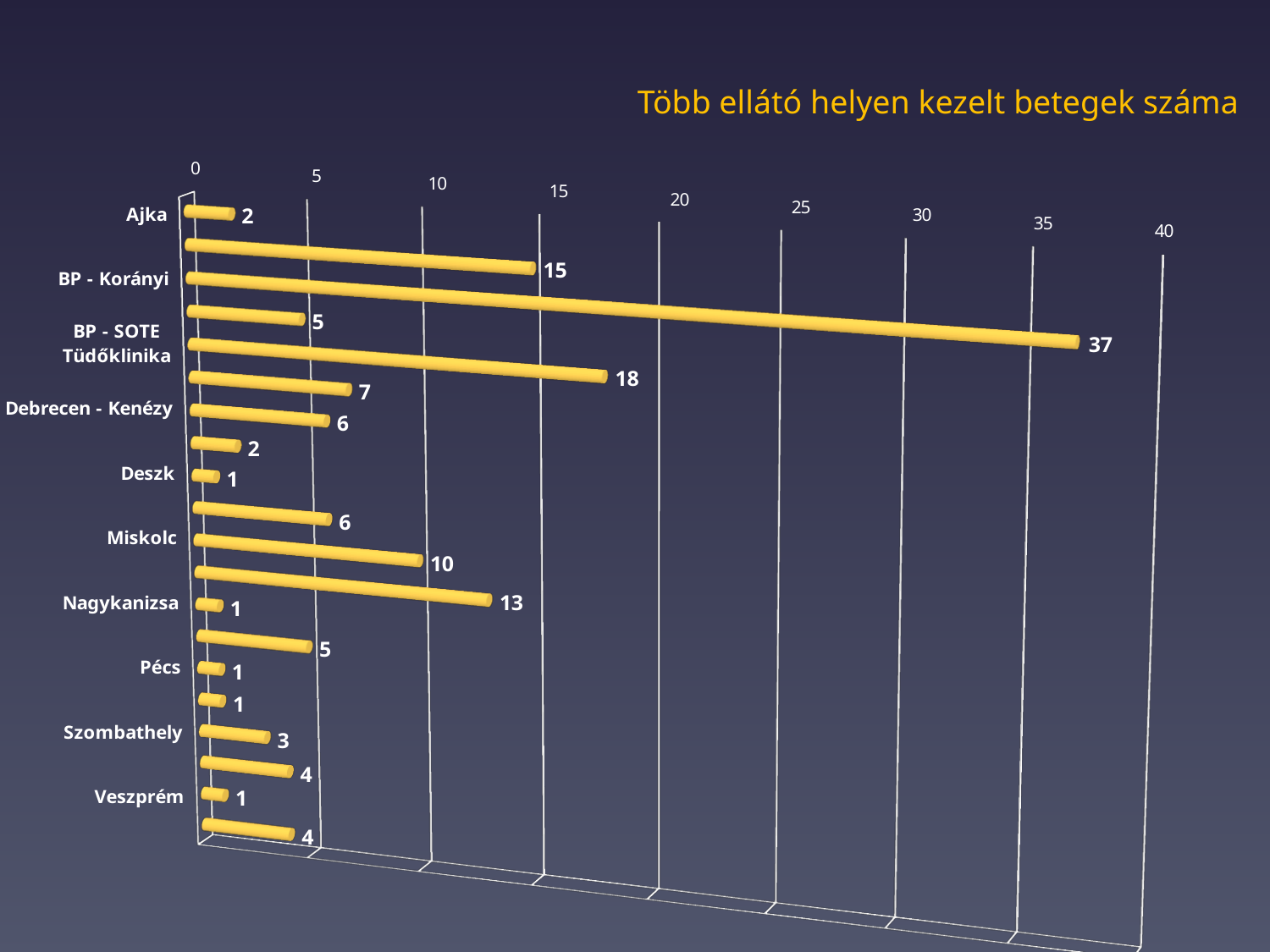
How many bars in the chart have the value 1? 5 Which is larger, the bar labelled 15 or the bar labelled 13? 15 What is the value of the bar for Ajka? 2 What is the title of the chart? Több ellátó helyen kezelt betegek száma What is the lowest value shown by any bar in the chart? 1 What is the maximum value shown on the horizontal axis? 40 What is the highest value shown by any bar in the chart? 37 How many category labels are printed on the vertical axis? 10 What kind of chart is shown on the slide? bar chart What is the difference between the highest bar value (37) and the second highest bar value (18)? 19 How many bars are plotted in the chart? 20 Is the longest bar in the chart greater or less than 35? greater